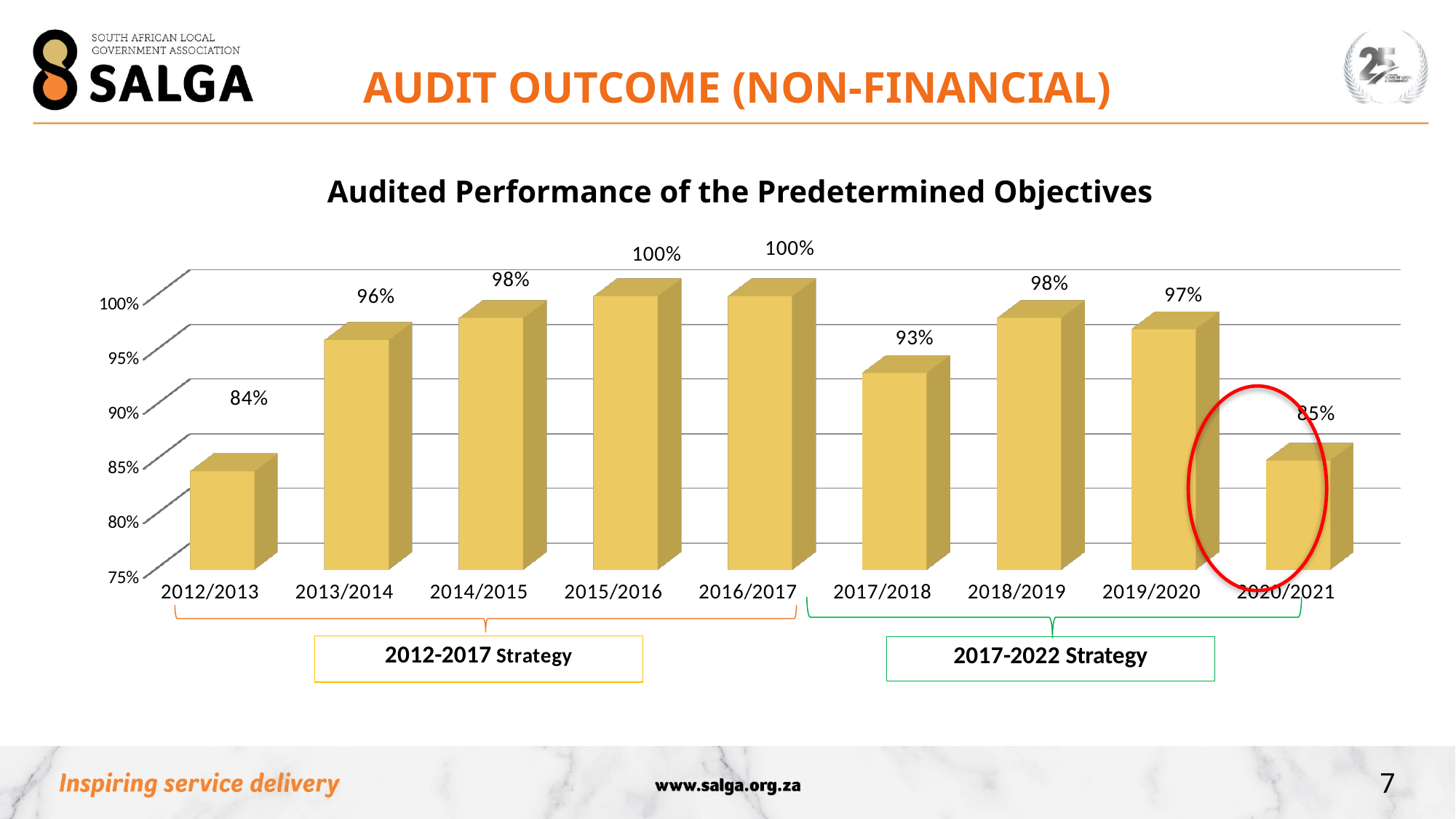
Which year has the lowest audited performance value? 2012/2013 Do the values rise or fall from 2012/2013 to 2016/2017? Rise What is the difference between the values for 2019/2020 and 2020/2021? 12% What is the audited performance value for 2017/2018? 93% What is the title of the chart? Audited Performance of the Predetermined Objectives What is the difference between the values for 2016/2017 and 2017/2018? 7% How many years are shown on the x axis of the chart? 9 What is the audited performance value for 2012/2013? 84% What is the audited performance value for 2020/2021? 85% Which is larger, the value for 2013/2014 or the value for 2018/2019? 2018/2019 What kind of chart is shown on the slide? Bar chart What is the audited performance value for 2019/2020? 97%